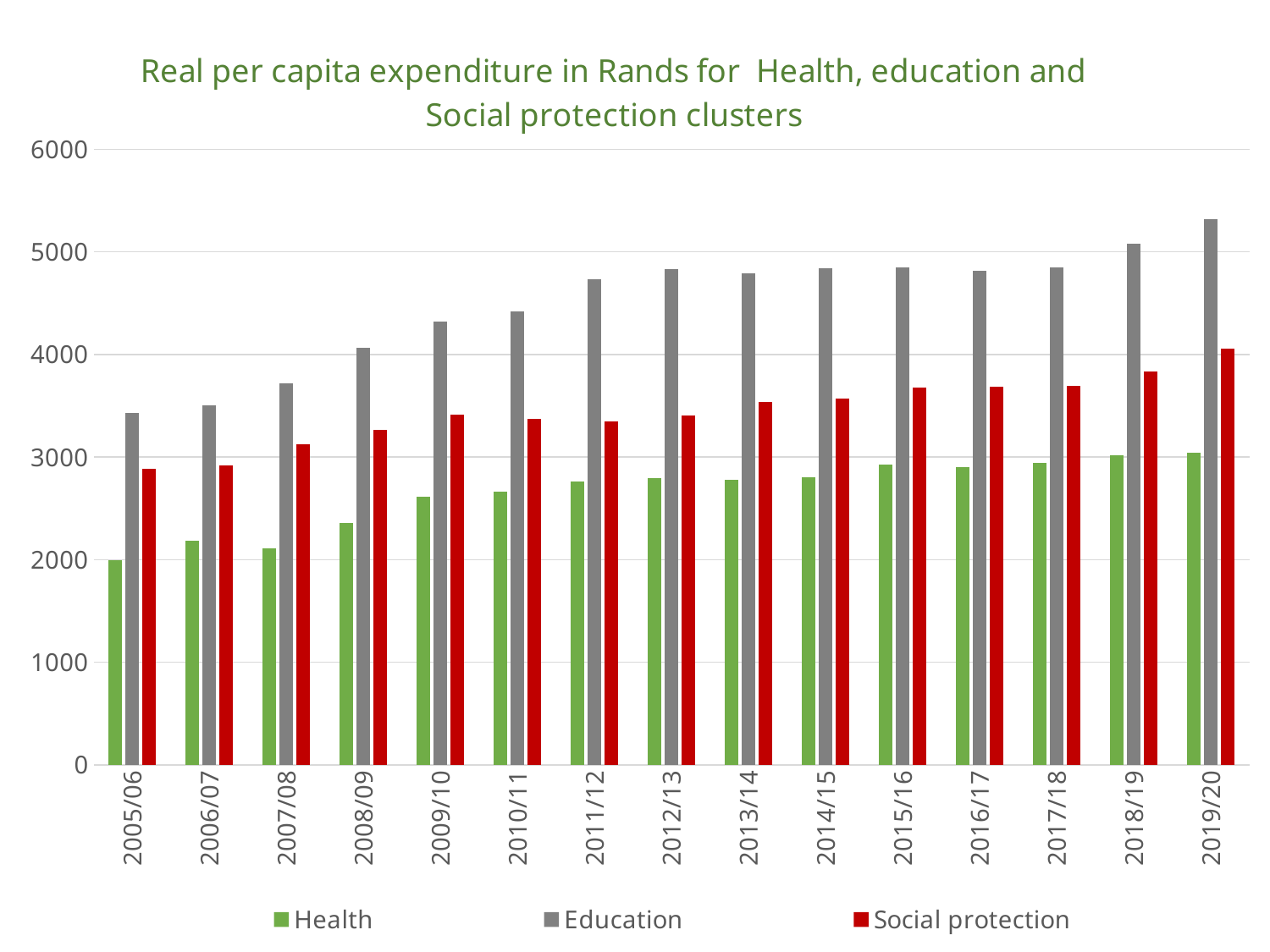
In which year is the Social protection bar highest? 2019/20 Which colour represents Social protection in the legend? red What kind of chart is shown on the slide? bar chart Is the value for Education in 2019/20 greater or less than 5000? greater Is the value for Health in 2008/09 greater or less than 3000? less In which year is the Health bar lowest? 2005/06 Does the Education series generally rise or fall from 2005/06 to 2019/20? rise How many series does the legend list? 3 Is the value for Social protection in 2005/06 greater or less than 3000? less Which is larger in 2012/13, Education or Social protection? Education How many financial years are shown on the x axis? 15 In which year is the Education bar highest? 2019/20